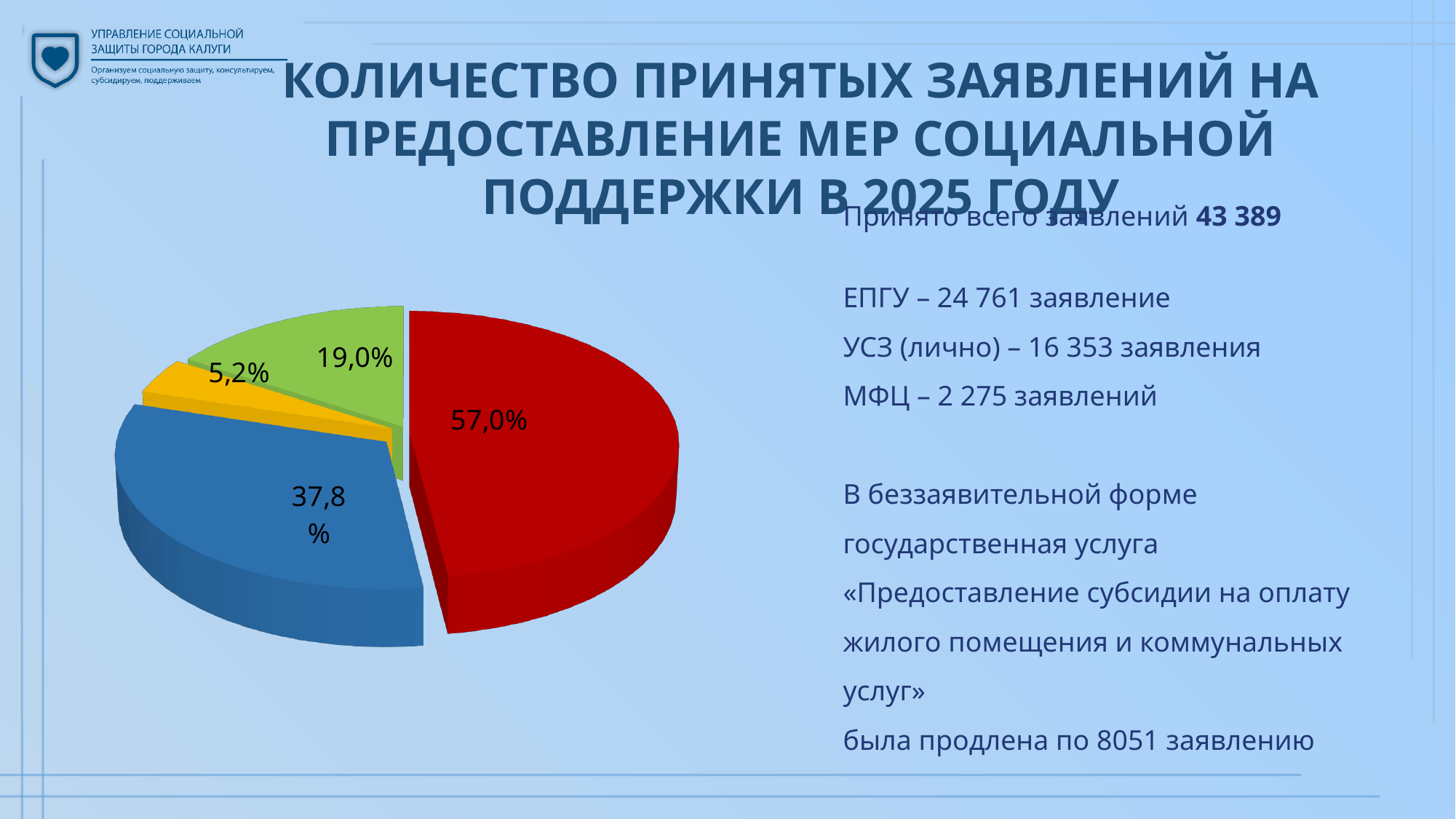
What kind of chart is shown on the slide? pie chart What percentage is labelled on the green slice of the pie chart? 19,0% What percentage is labelled on the blue slice of the pie chart? 37,8% What is the difference in percentage points between the red slice (57,0%) and the blue slice (37,8%)? 19,2 What is the smallest share shown in the pie chart? 5,2% What percentage is labelled on the yellow slice of the pie chart? 5,2% Which slice is larger, the red one or the blue one? the red one What is the difference in percentage points between the green slice (19,0%) and the yellow slice (5,2%)? 13,8 What is the largest share shown in the pie chart? 57,0% What colour is the largest slice of the pie chart? red What percentage is labelled on the red slice of the pie chart? 57,0% How many slices does the pie chart have? 4